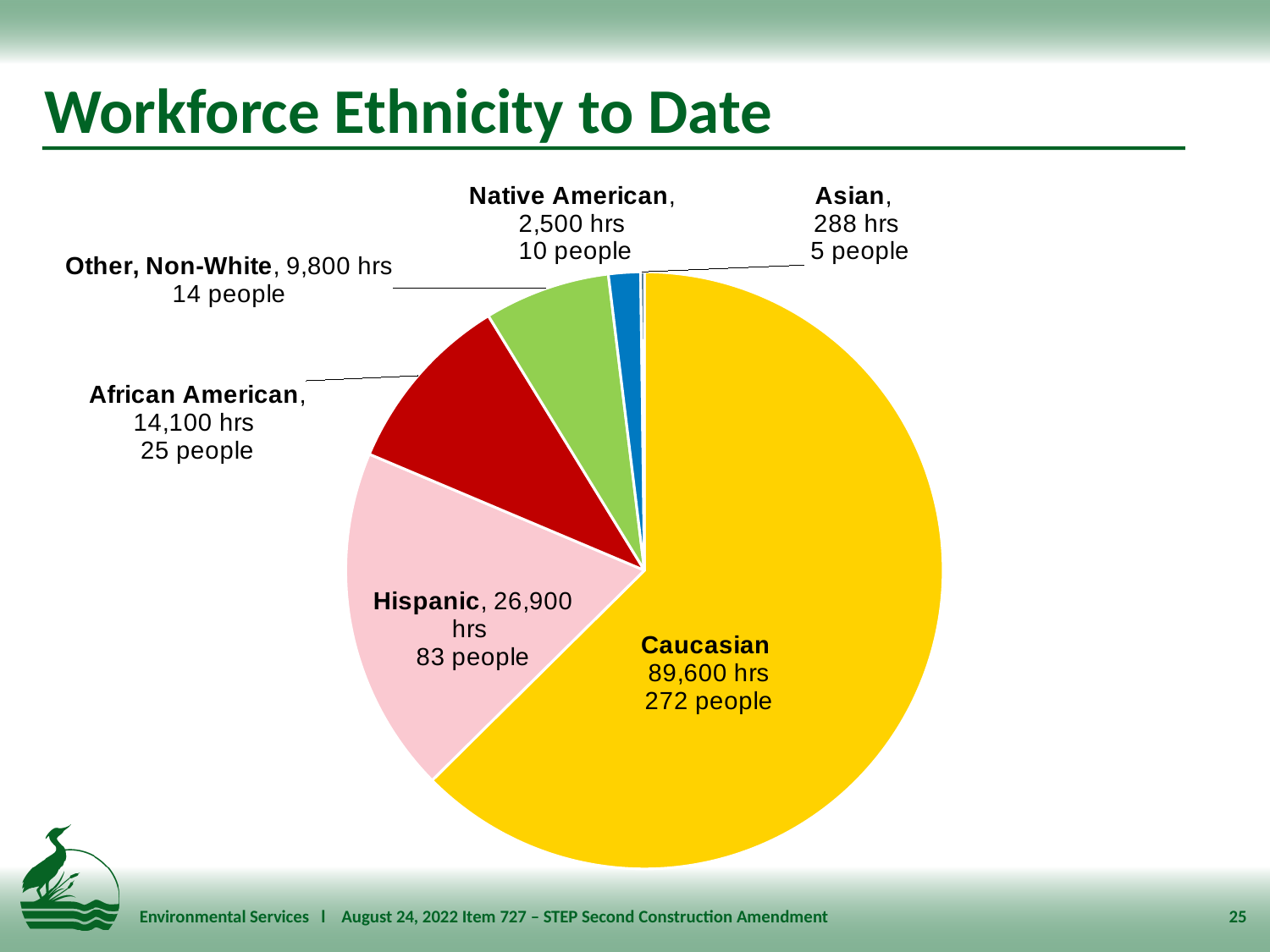
Which category has the largest slice of the pie? Caucasian What is the difference in the number of people between African American and Native American? 15 people How many hours are shown for Caucasian? 89,600 hrs How many people are shown for Asian? 5 people What is the title of the chart on the slide? Workforce Ethnicity to Date Which has more hours, Native American or Other, Non-White? Other, Non-White What is the difference in hours between Caucasian and Hispanic? 62,700 hrs How many ethnicity categories does the pie chart show? 6 Which category has the smallest slice of the pie? Asian How many hours are shown for African American? 14,100 hrs What kind of chart is shown on the slide? Pie chart How many people are shown for Hispanic? 83 people